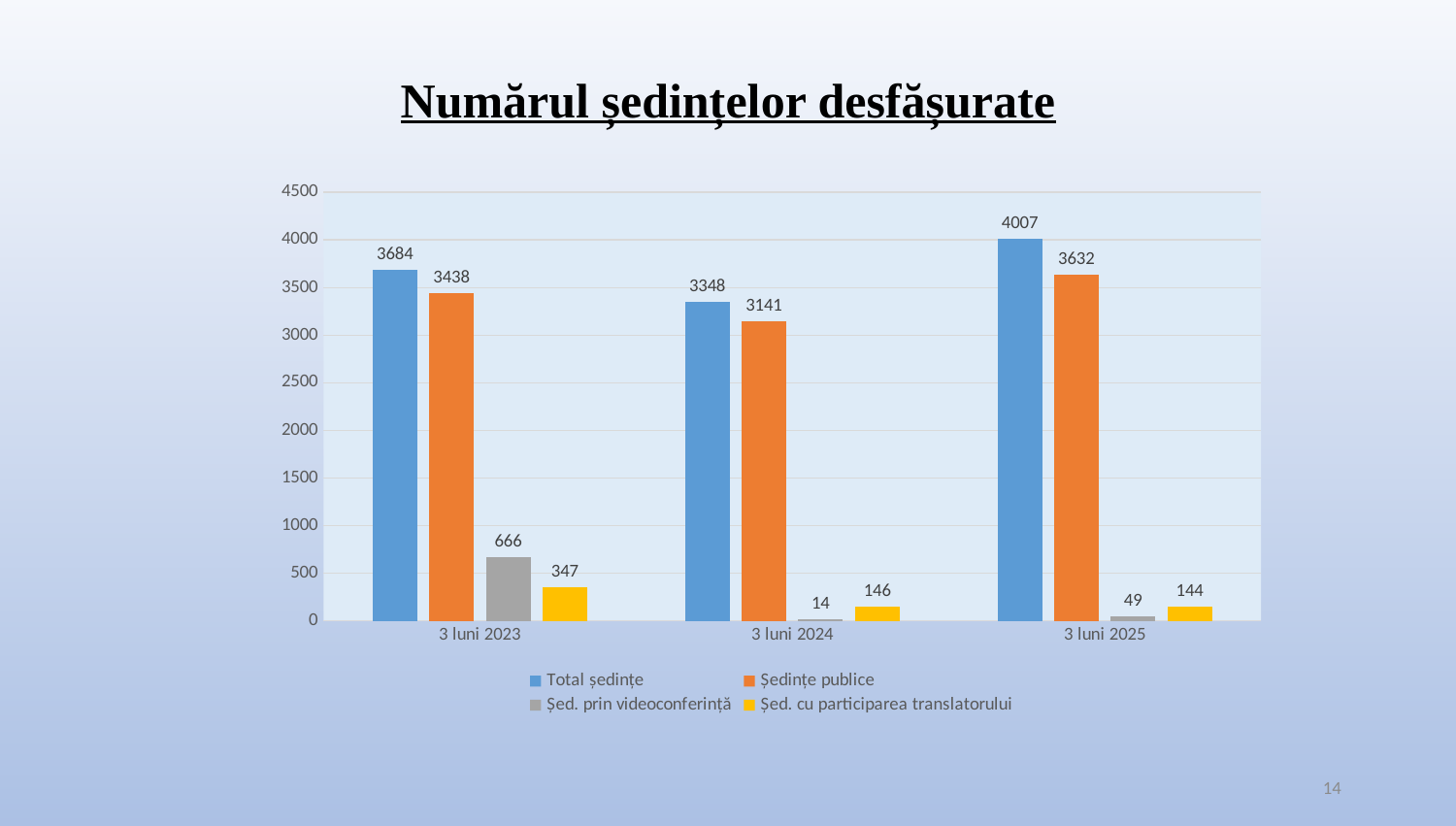
Which period has the highest value for Total ședințe? 3 luni 2025 What kind of chart is shown on the slide? bar chart Is the value of Total ședințe for 3 luni 2024 greater or less than 3500? less What is the difference between Total ședințe and Ședințe publice for 3 luni 2023? 246 What is the value of Ședințe publice for 3 luni 2024? 3141 What is the value of Total ședințe for 3 luni 2025? 4007 Which is larger: Șed. cu participarea translatorului for 3 luni 2024 or for 3 luni 2025? 3 luni 2024 What is the value of Șed. prin videoconferință for 3 luni 2023? 666 How many periods are shown on the x axis? 3 How many series does the legend list? 4 What is the value of Șed. cu participarea translatorului for 3 luni 2025? 144 Which period has the lowest value for Șed. prin videoconferință? 3 luni 2024